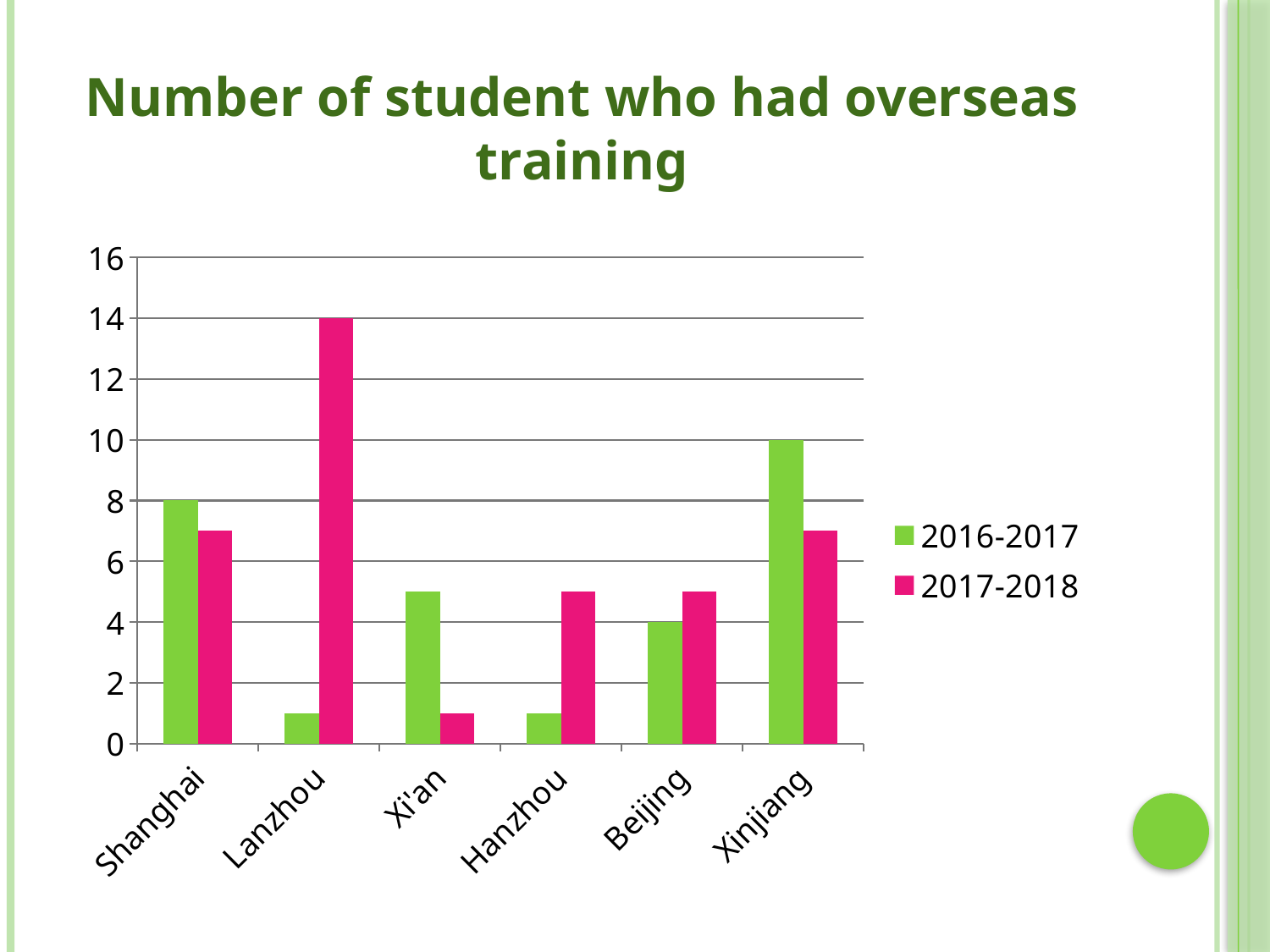
How many series does the legend list? 2 What is the value for Lanzhou in 2017-2018? 14 What is the value for Beijing in 2016-2017? 4 What is the difference between the 2016-2017 values for Xinjiang and Shanghai? 2 How many cities are shown on the x axis? 6 What type of chart is shown on the slide? bar chart What is the value for Xinjiang in 2016-2017? 10 Which city has the highest value in 2016-2017? Xinjiang Is the value for Xi'an in 2017-2018 greater or less than 2? less What is the title of the chart? Number of student who had overseas training Which city has the highest value in 2017-2018? Lanzhou What is the value for Shanghai in 2016-2017? 8